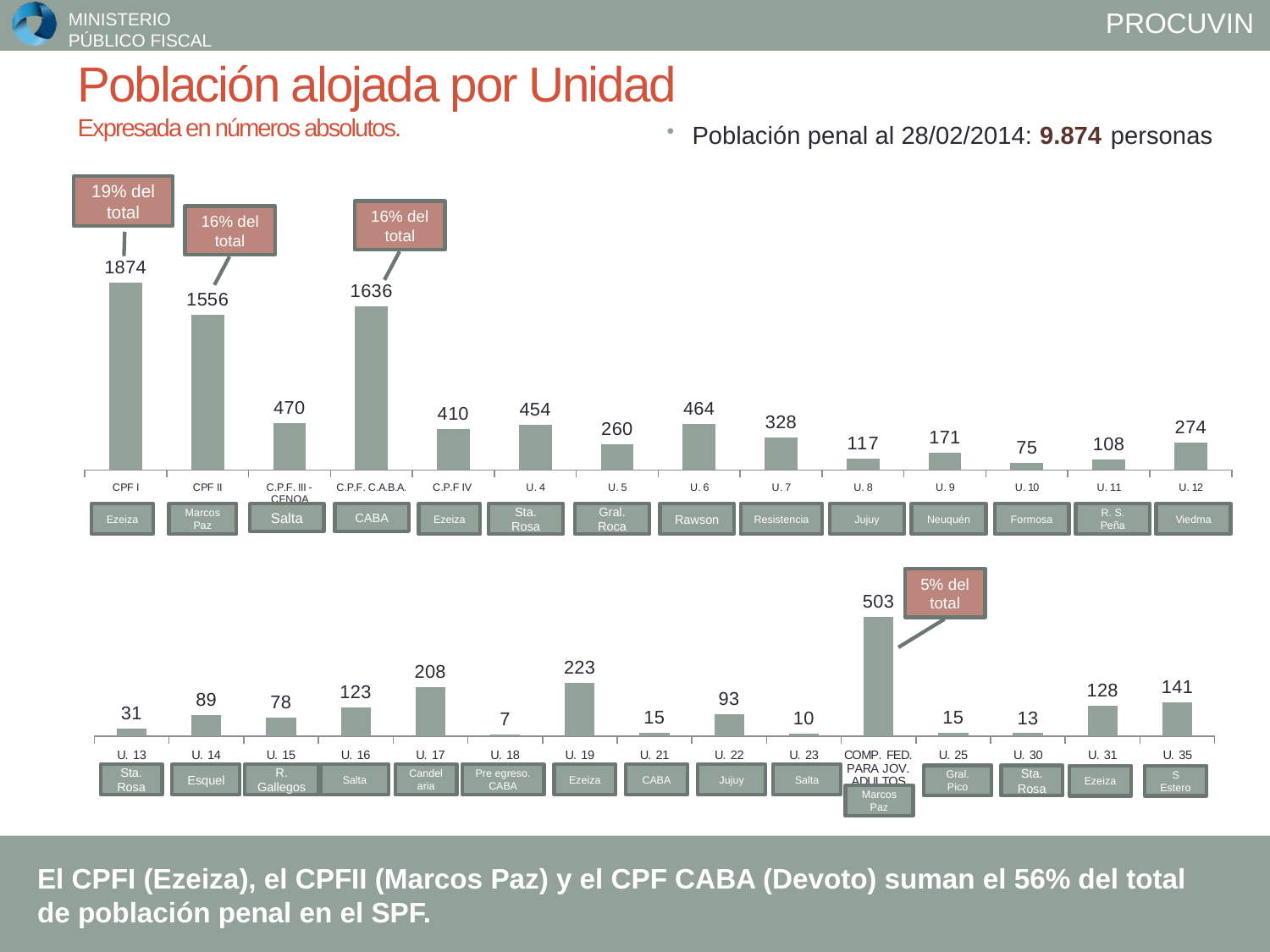
How many units are shown in the bottom chart? 15 In the bottom chart, what is the value for U. 19? 223 What type of chart is used on this slide? Bar chart In the top chart, which unit has the highest value? CPF I In the bottom chart, which unit has the lowest value? U. 18 In the top chart, which unit has the lowest value? U. 10 In the top chart, what is the difference between the values for CPF I and CPF II? 318 In the bottom chart, which category has the highest value? COMP. FED. PARA JOV. ADULTOS In the top chart, what is the value for U. 7? 328 According to the callout in the top chart, what share of the total does CPF I represent? 19% del total In the bottom chart, which is larger, the value for U. 17 or the value for U. 35? U. 17 In the top chart, what is the value for CPF I? 1874